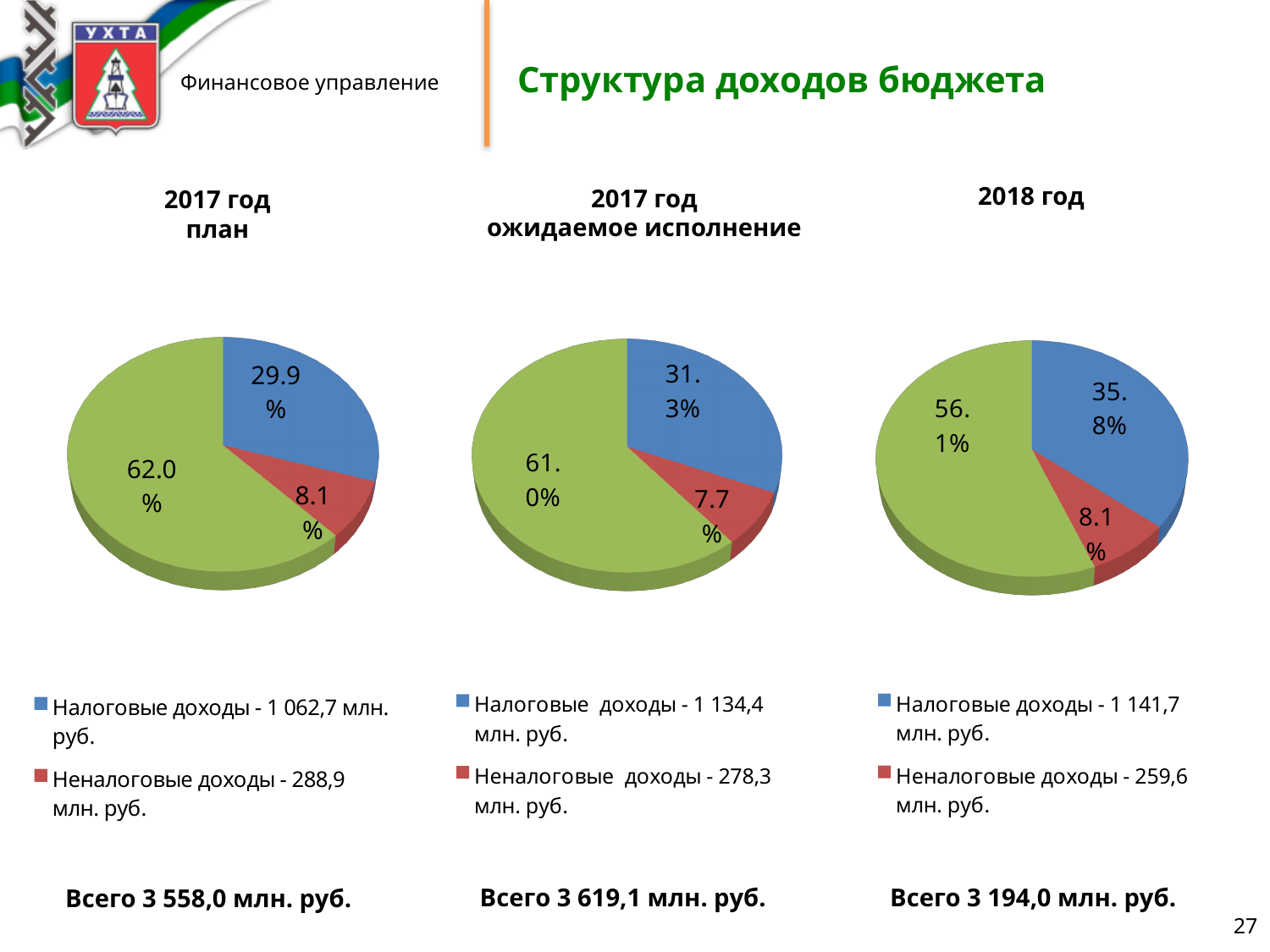
In the '2018 год' chart, what is the largest slice's share? 56.1% How many slices does the '2017 год ожидаемое исполнение' pie chart have? 3 How many entries does the legend of the '2018 год' chart list? 2 In the '2017 год план' chart, what share is shown for Налоговые доходы? 29.9% What kind of chart is used for the '2017 год план' chart? Pie chart In the '2018 год' chart, what share is shown for Налоговые доходы? 35.8% In the '2017 год ожидаемое исполнение' chart, what share is shown for Налоговые доходы? 31.3% In the '2018 год' chart, what is the difference between the Налоговые доходы share and the Неналоговые доходы share? 27.7% In the '2017 год план' chart, which slice is the smallest? Неналоговые доходы In the '2017 год ожидаемое исполнение' chart, what share is shown for Неналоговые доходы? 7.7% In the '2017 год план' chart, what share is shown for Неналоговые доходы? 8.1% Which is larger: the Налоговые доходы share in the '2017 год план' chart or in the '2018 год' chart? 2018 год